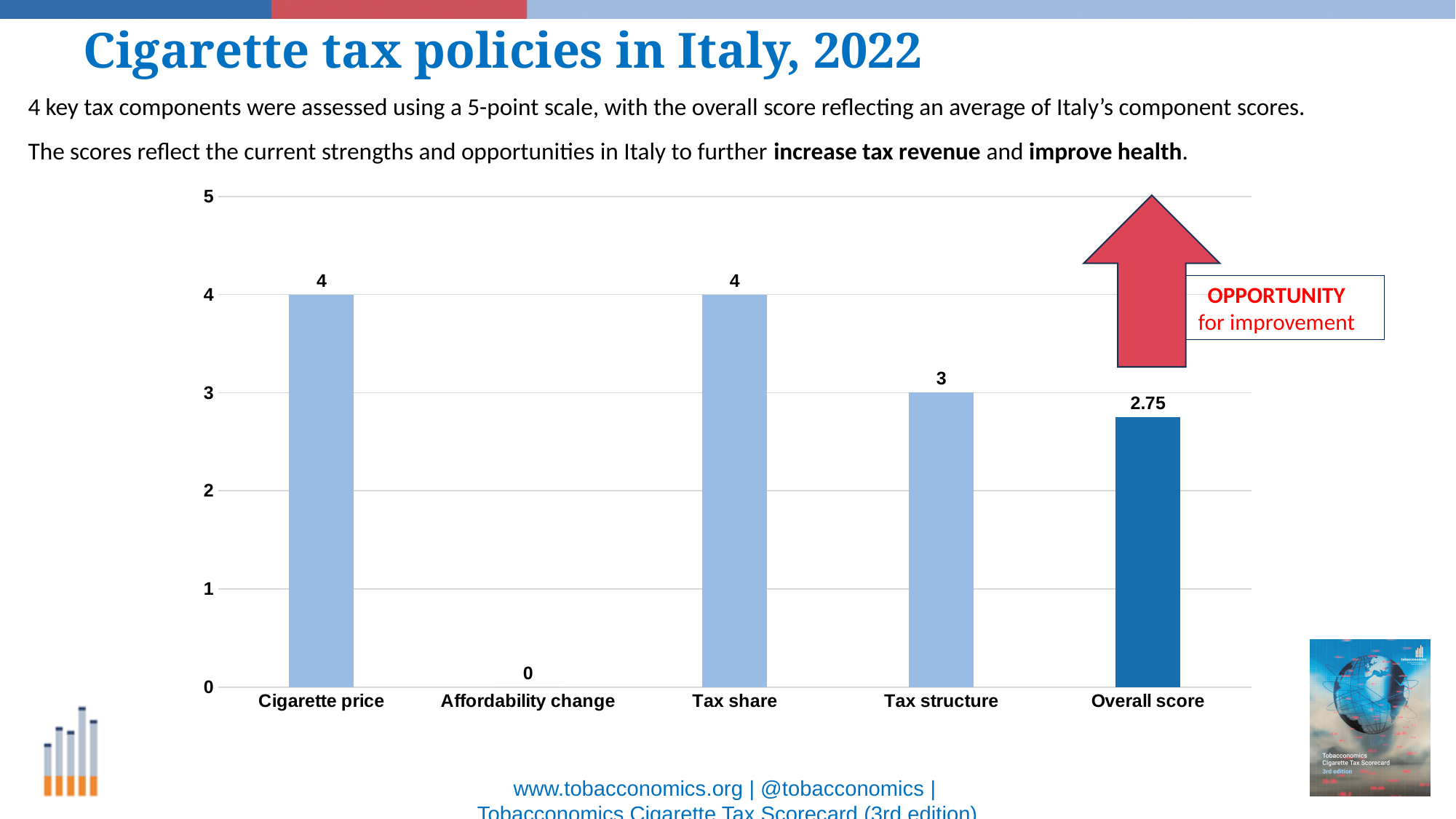
What is the score for Affordability change? 0 What is the difference between the Tax share score and the Tax structure score? 1 What is the Overall score shown on the chart? 2.75 Which category has the lowest score? Affordability change Is the Overall score greater or less than 3? less What is the score for Tax structure? 3 What kind of chart is shown on the slide? bar chart What is the difference between the Tax structure score and the Overall score? 0.25 What is the maximum value shown on the y axis of the chart? 5 Which is larger, the score for Tax structure or the Overall score? Tax structure What is the score for Cigarette price? 4 How many categories are shown on the x axis of the chart? 5